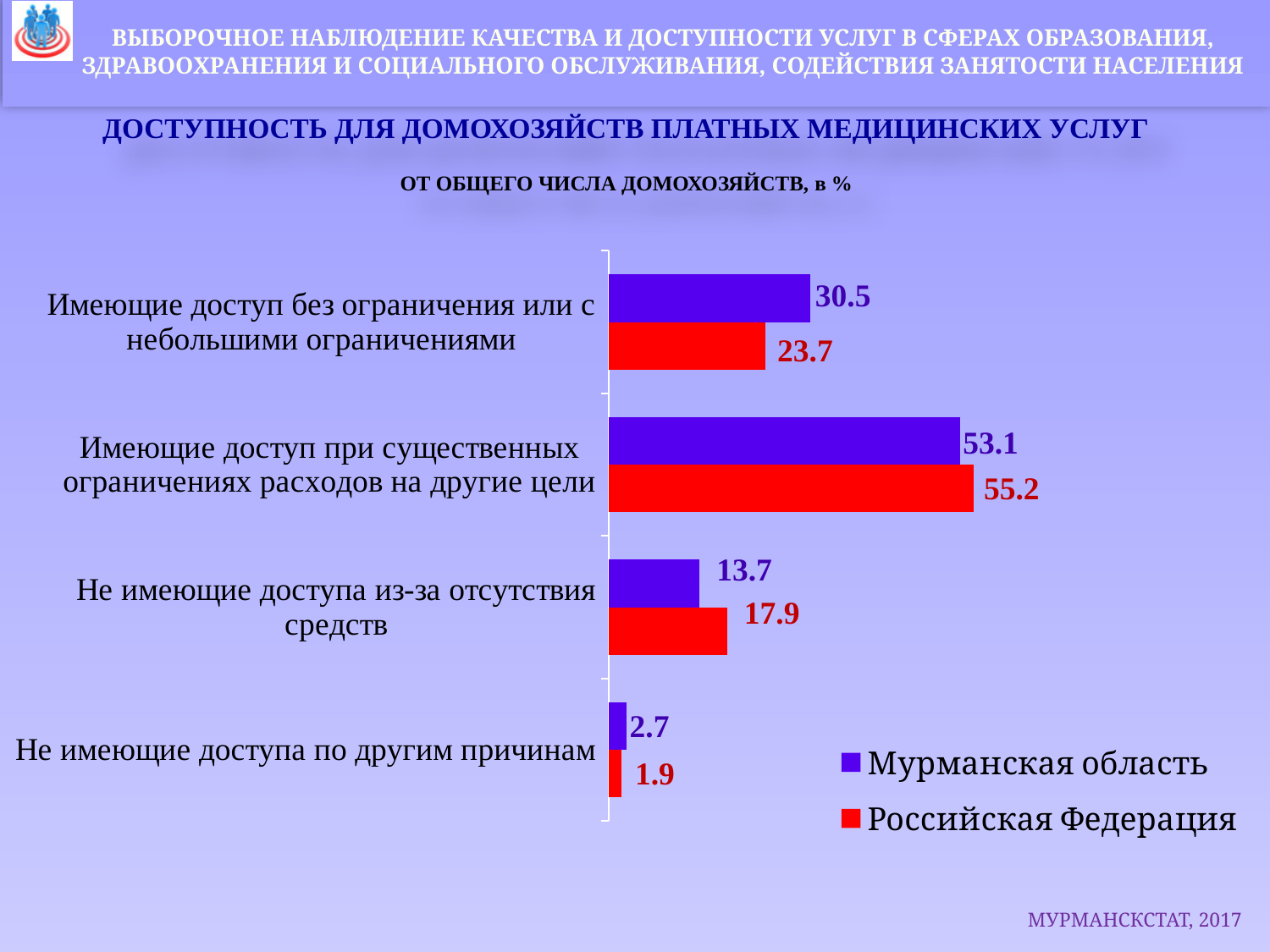
What is the value for Мурманская область in the category "Не имеющие доступа по другим причинам"? 2.7 How many series does the legend list? 2 Which category has the lowest value for Российская Федерация? Не имеющие доступа по другим причинам What is the value for Российская Федерация in the category "Имеющие доступ при существенных ограничениях расходов на другие цели"? 55.2 Which category has the highest value for Мурманская область? Имеющие доступ при существенных ограничениях расходов на другие цели What is the difference between Российская Федерация and Мурманская область in the category "Не имеющие доступа из-за отсутствия средств"? 4.2 In the category "Имеющие доступ при существенных ограничениях расходов на другие цели", which series has the larger value: Мурманская область or Российская Федерация? Российская Федерация What kind of chart is shown on the slide? Bar chart What is the value for Российская Федерация in the category "Не имеющие доступа из-за отсутствия средств"? 17.9 How many categories are shown on the chart? 4 What is the difference between Мурманская область and Российская Федерация in the category "Имеющие доступ без ограничения или с небольшими ограничениями"? 6.8 What is the value for Мурманская область in the category "Имеющие доступ без ограничения или с небольшими ограничениями"? 30.5